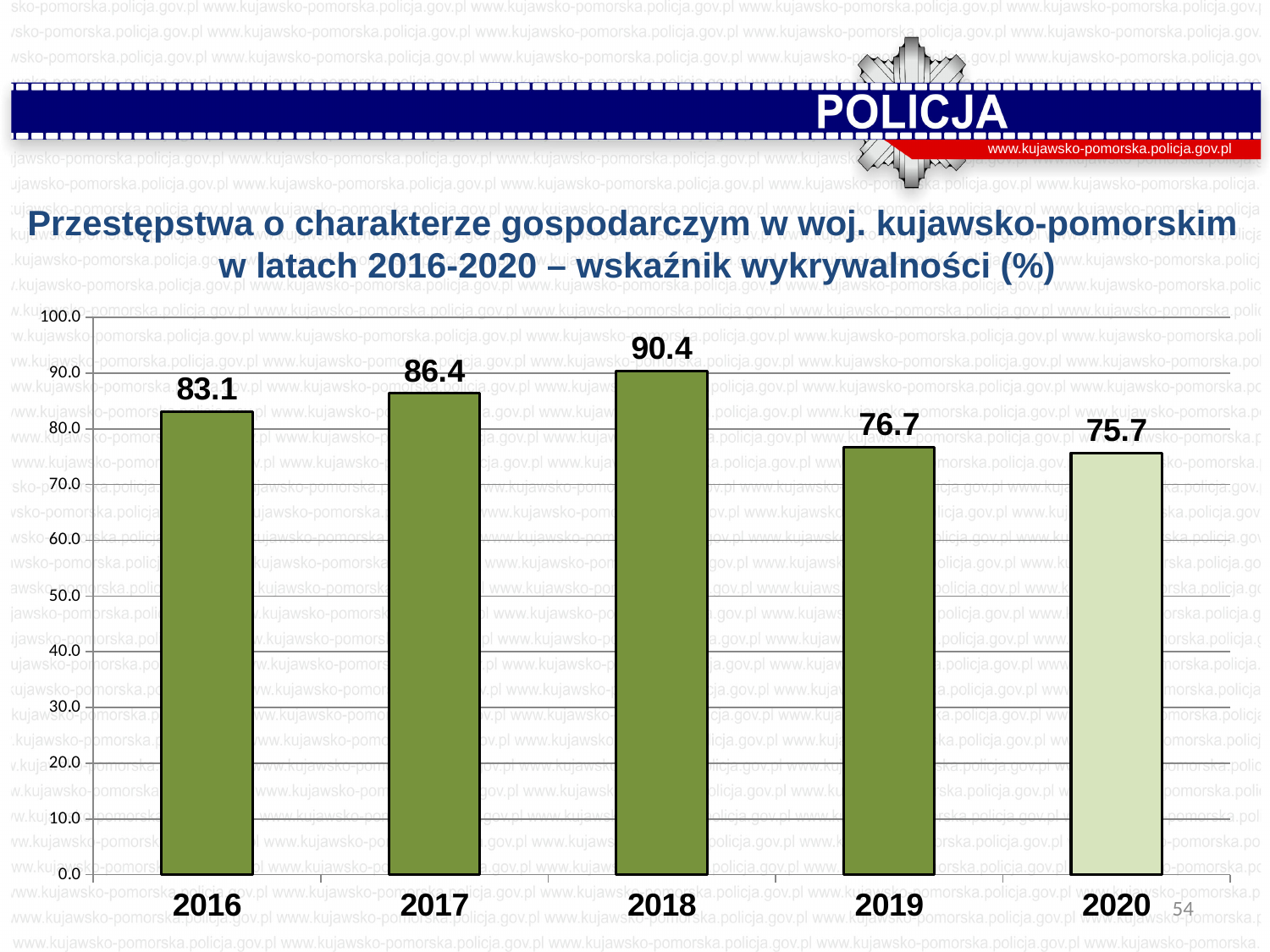
What is the difference between the values for 2017 and 2016? 3.3 Is the value for 2019 greater or less than 80.0? less How many years are shown on the x axis? 5 What kind of chart is shown on the slide? bar chart Which year has the highest value? 2018 Which is larger, the value for 2017 or the value for 2019? 2017 Which year has the lowest value? 2020 Do the values rise or fall from 2018 to 2020? fall What is the detection rate value shown for 2018? 90.4 What is the difference between the values for 2018 and 2020? 14.7 What is the value shown for 2016? 83.1 What is the value shown for 2020? 75.7